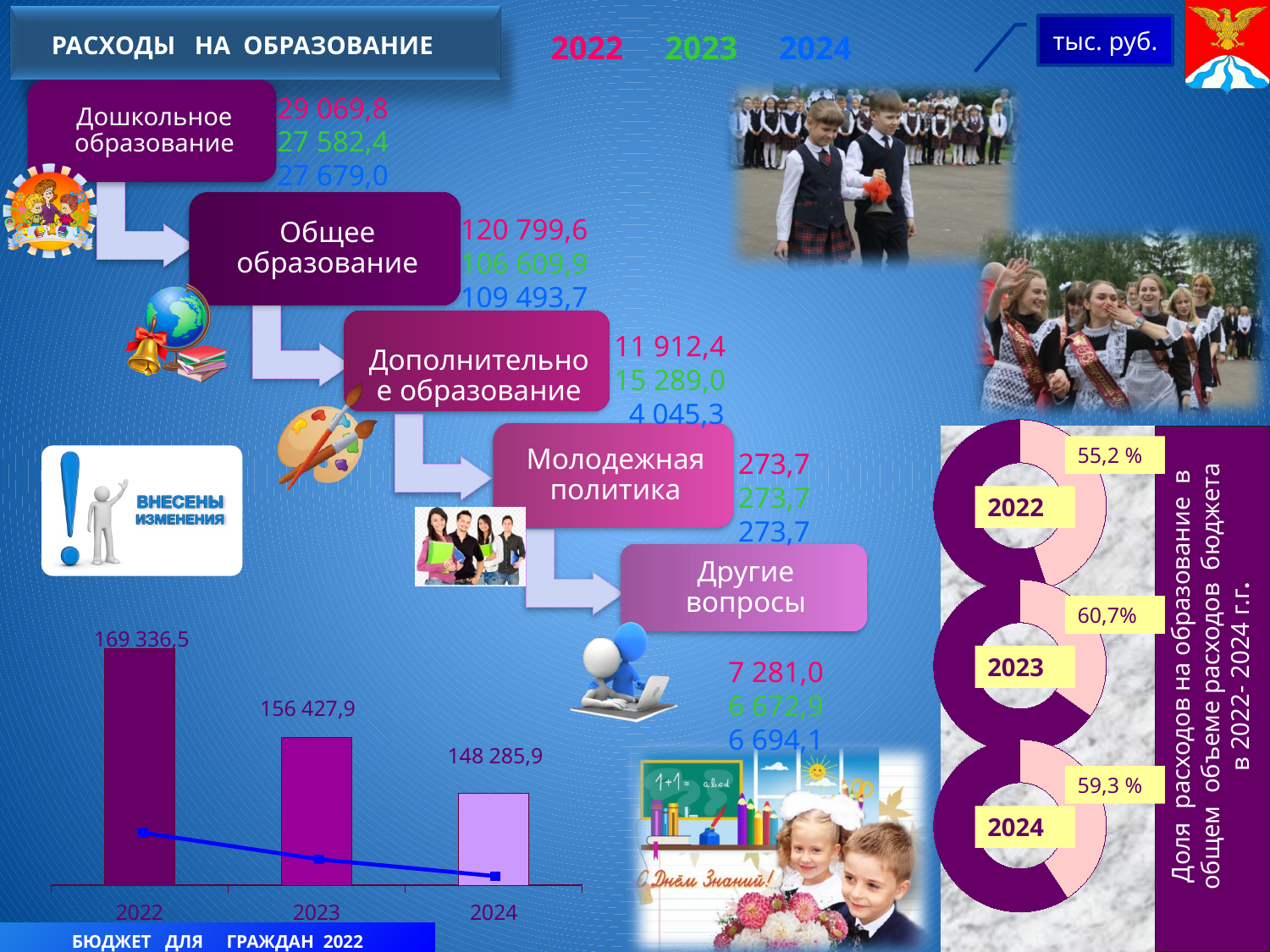
In the bar chart at the bottom left, do the values rise or fall from 2022 to 2024? fall In the donut charts on the right (share of education spending in the total budget), what is the value for 2023? 60,7% In the bar chart at the bottom left, what is the value for 2022? 169 336,5 In the donut charts on the right (share of education spending in the total budget), which year has the lowest share? 2022 In the bar chart at the bottom left, which year has the lowest value? 2024 In the bar chart at the bottom left, which year has the highest value? 2022 In the bar chart at the bottom left, what is the value for 2023? 156 427,9 In the bar chart at the bottom left, what is the value for 2024? 148 285,9 In the bar chart at the bottom left, what is the difference between the values for 2023 and 2024? 8 142,0 How many bars are in the bar chart at the bottom left? 3 What kind of chart is shown at the bottom left of the slide? bar chart In the bar chart at the bottom left, what is the difference between the values for 2022 and 2023? 12 908,6